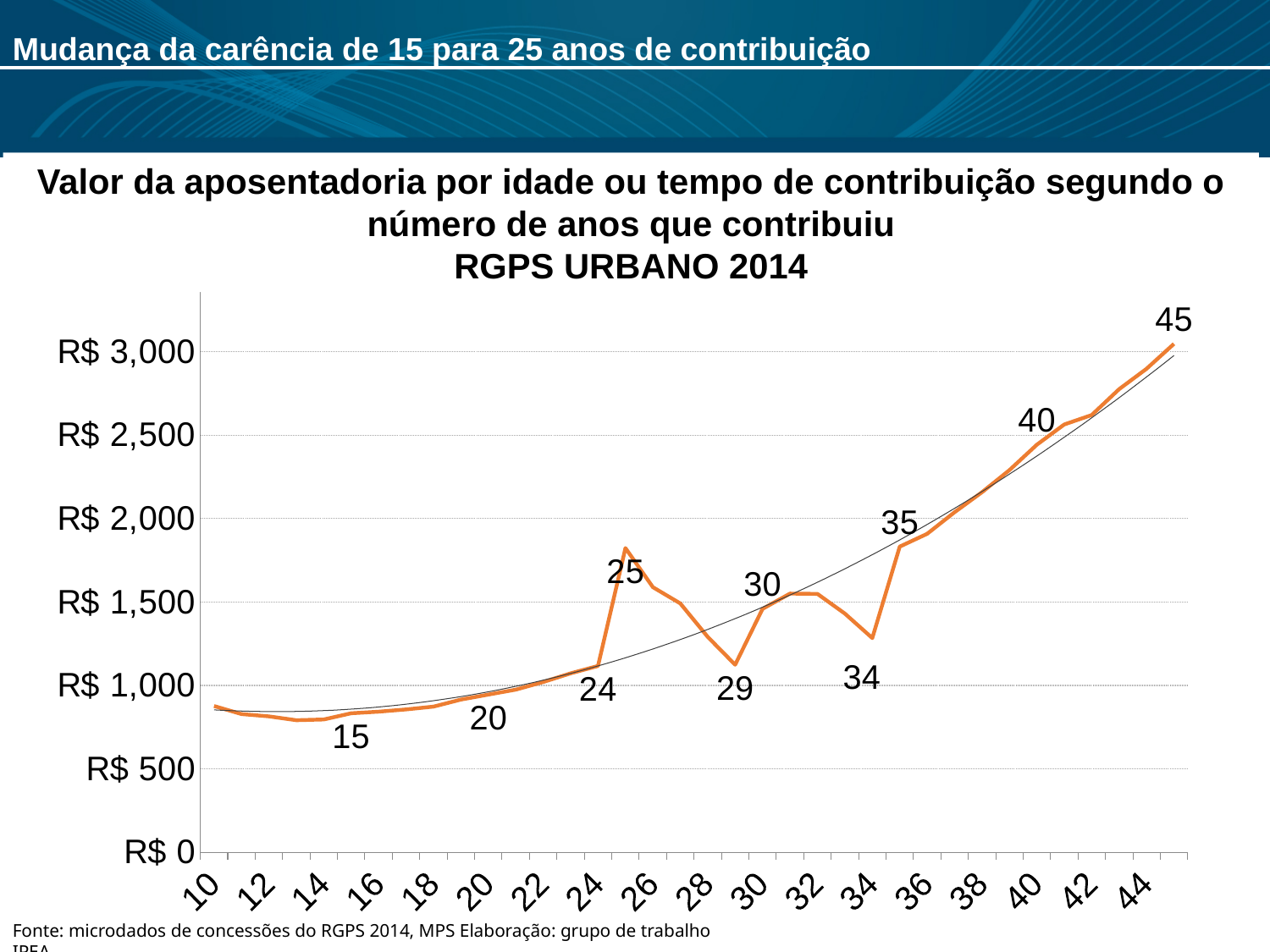
What year does the chart title say the RGPS URBANO data refers to? 2014 Which has a higher retirement benefit value: 35 years of contribution or 40 years of contribution? 40 Is the value for 34 years of contribution greater or less than R$ 1,500? less Is the value for 15 years of contribution greater or less than R$ 1,000? less Overall, does the value of the retirement benefit rise or fall as the number of years of contribution increases from 10 to 45? rise Is the value for 20 years of contribution greater or less than R$ 1,000? less What kind of chart is shown on the slide? line chart At which number of years of contribution is the retirement benefit value highest? 45 Which has a higher retirement benefit value: 25 years of contribution or 30 years of contribution? 25